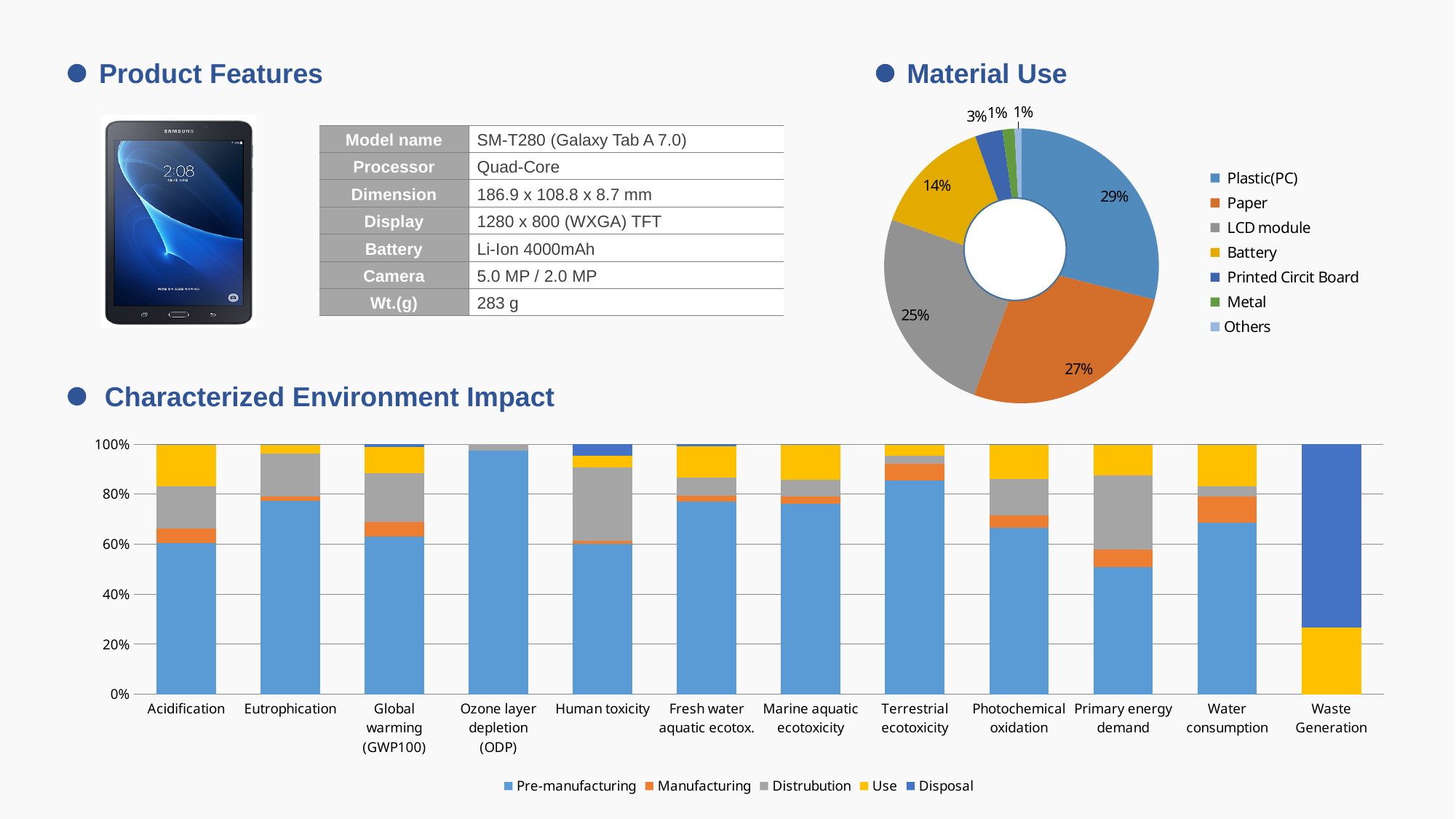
How many impact categories are shown on the x axis of the Characterized Environment Impact chart? 12 In the Material Use chart, what share does Plastic(PC) account for? 29% How many series does the legend of the Characterized Environment Impact chart list? 5 How many materials are listed in the legend of the Material Use chart? 7 In the Material Use chart, what percentage is shown for Battery? 14% What kind of chart is the Characterized Environment Impact chart? Stacked bar chart In the Material Use chart, which is larger, the share for Battery or the share for Printed Circit Board? Battery In the Characterized Environment Impact chart, is the Use value for Waste Generation greater or less than 40%? less In the Material Use chart, what is the difference between the Paper share and the LCD module share? 2% What kind of chart is the Material Use chart? Pie chart In the Characterized Environment Impact chart, is the Pre-manufacturing value for Ozone layer depletion (ODP) greater or less than 80%? greater In the Material Use chart, which material has the largest share? Plastic(PC)